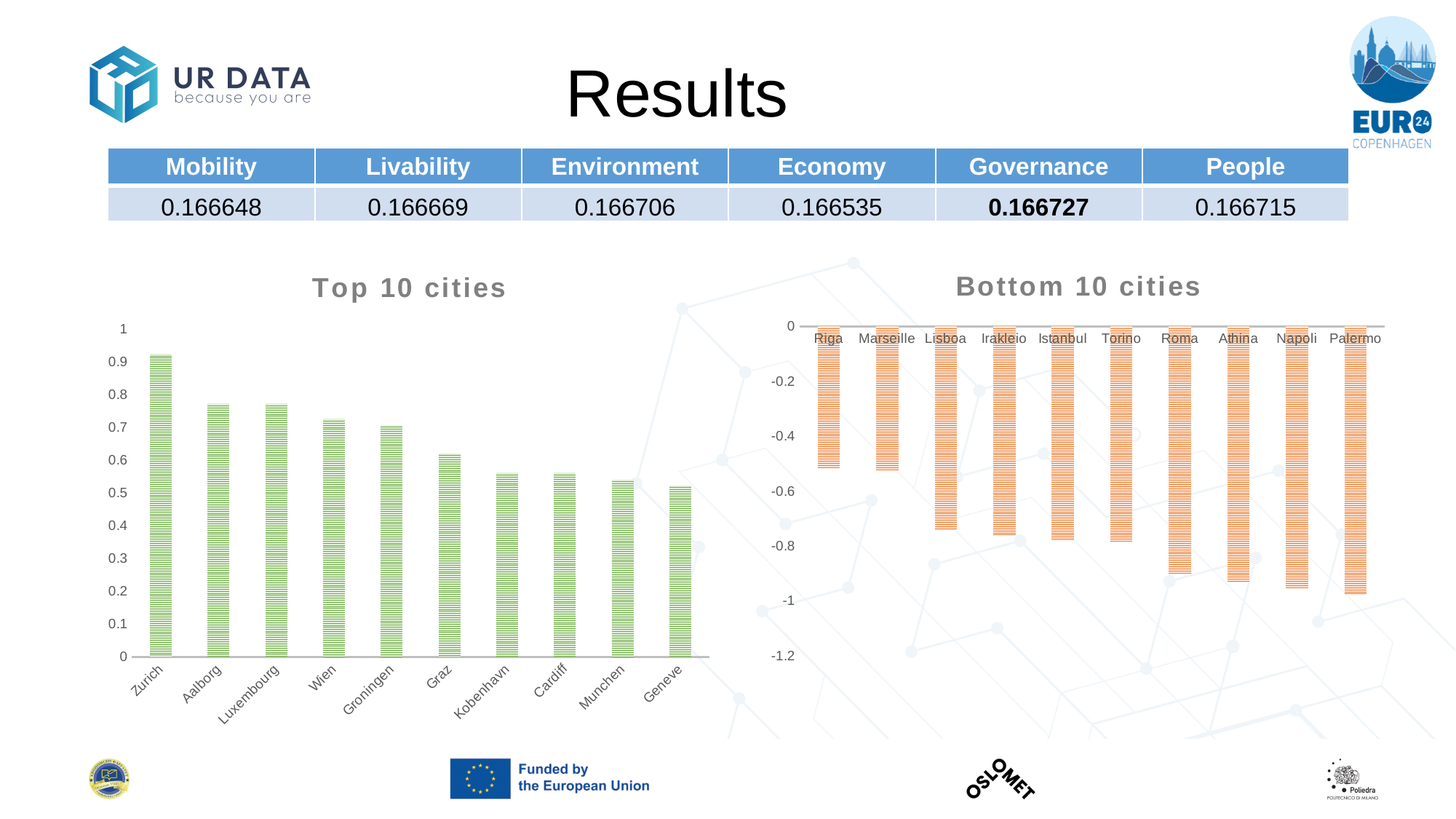
What kind of chart is the Top 10 cities chart? bar chart In the Top 10 cities chart, do the values rise or fall from left to right? fall In the Bottom 10 cities chart, which has the larger value, Riga or Roma? Riga In the Top 10 cities chart, is the value for Zurich greater or less than 0.9? greater In the Top 10 cities chart, is the value for Geneve greater or less than 0.6? less In the Top 10 cities chart, is the value for Wien greater or less than 0.7? greater In the Top 10 cities chart, which has the larger value, Zurich or Wien? Zurich How many cities are shown in the Top 10 cities chart? 10 What colour are the bars in the Bottom 10 cities chart? orange In the Top 10 cities chart, which city has the highest value? Zurich